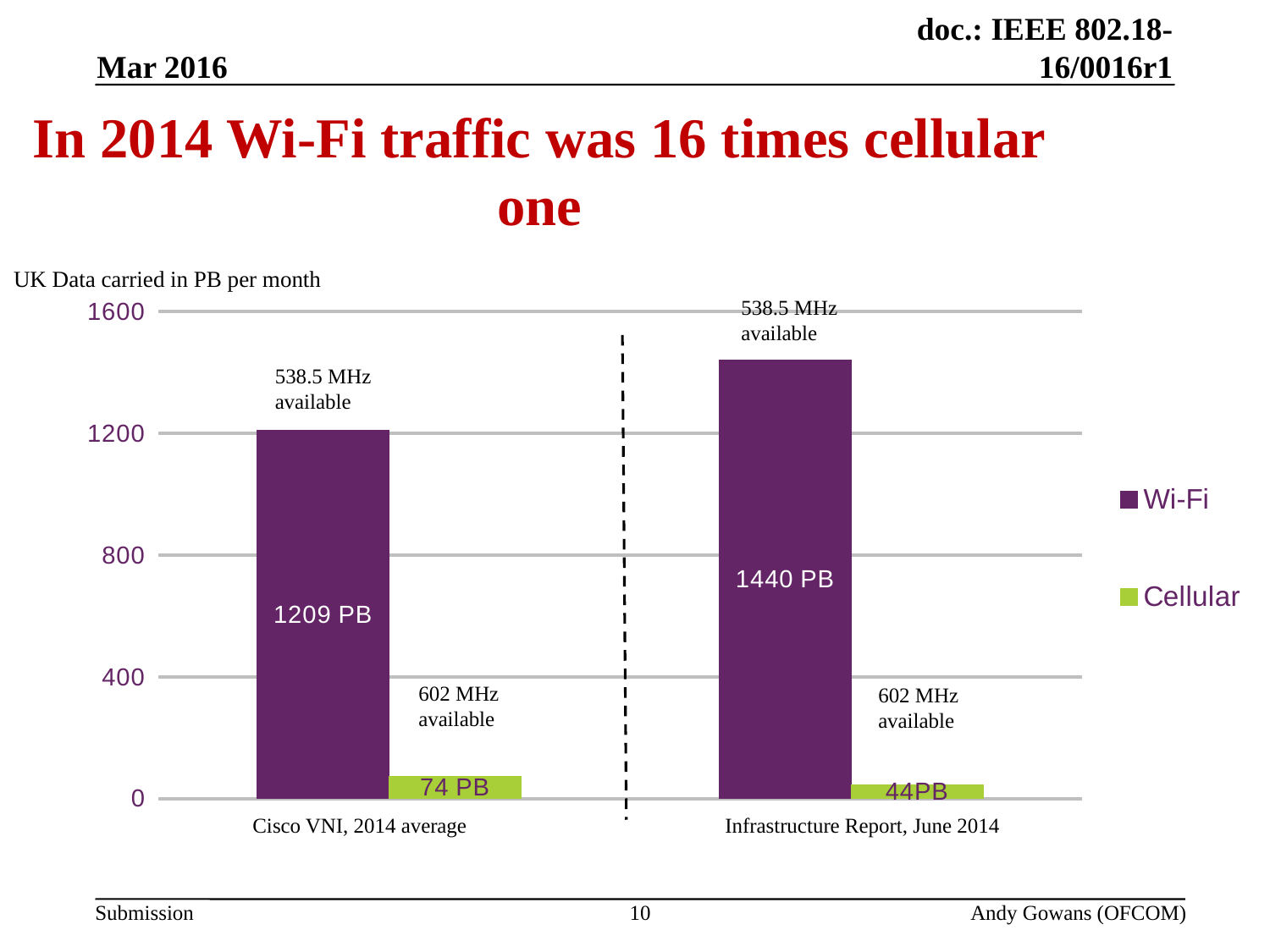
What is the Cellular value for Infrastructure Report, June 2014? 44PB Which category has the lowest Cellular value? Infrastructure Report, June 2014 How many series does the legend list? 2 Is the Wi-Fi value for Cisco VNI, 2014 average greater or less than 800? greater What is the difference between the Wi-Fi values for Infrastructure Report, June 2014 and Cisco VNI, 2014 average? 231 PB What kind of chart is shown on the slide? bar chart What is the Wi-Fi value for Cisco VNI, 2014 average? 1209 PB What is the Wi-Fi value for Infrastructure Report, June 2014? 1440 PB What is the Cellular value for Cisco VNI, 2014 average? 74 PB How many categories are shown on the x axis? 2 Which is larger for Cisco VNI, 2014 average: Wi-Fi or Cellular? Wi-Fi Which category has the highest Wi-Fi value? Infrastructure Report, June 2014